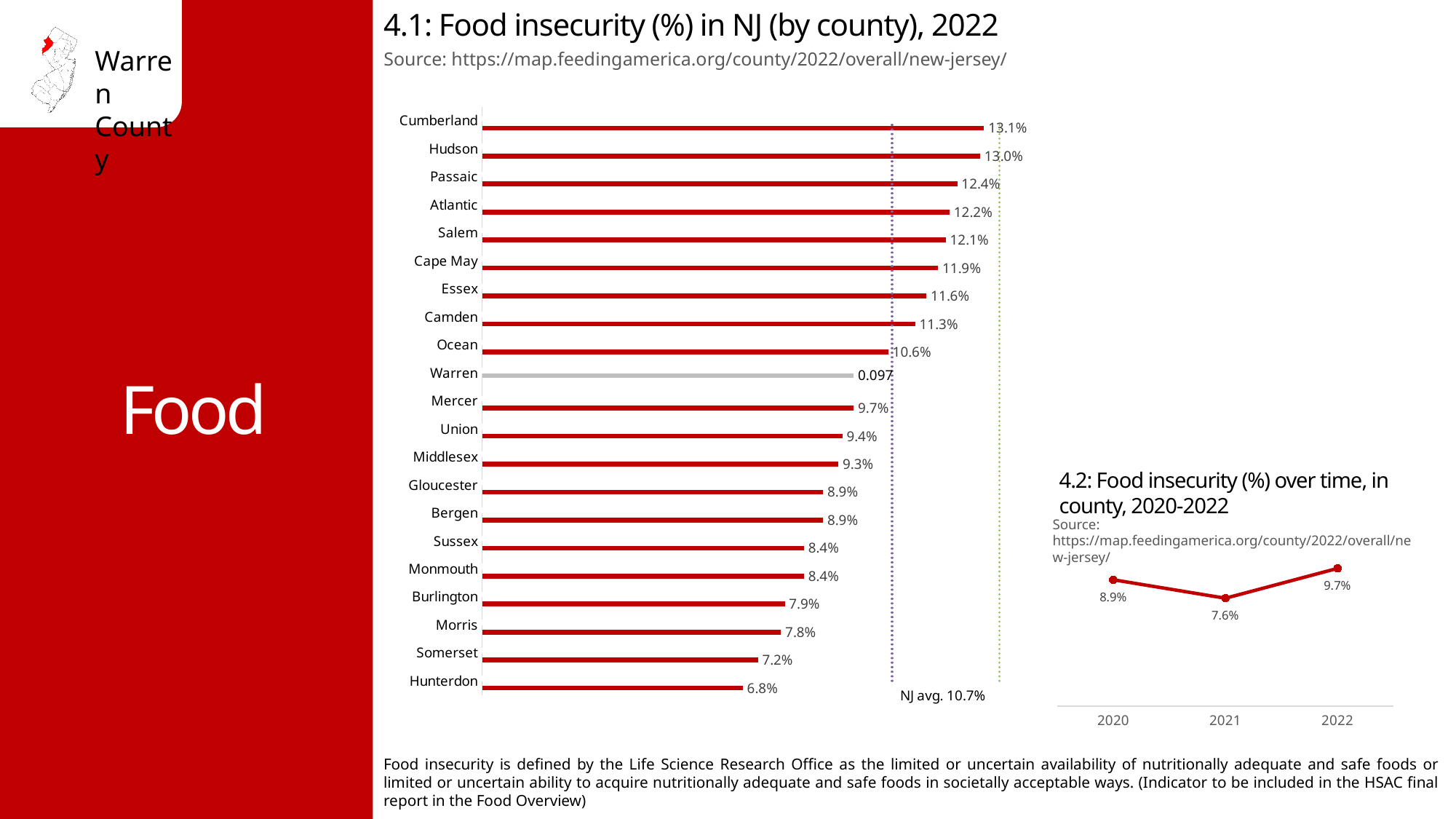
In chart 4.1, which county has the highest food insecurity rate? Cumberland In chart 4.1, what NJ average value is marked by the dotted reference line? 10.7% In chart 4.1, what is the food insecurity rate for Ocean? 10.6% In chart 4.2, what is the food insecurity rate for 2021? 7.6% In chart 4.1, what is the difference between the food insecurity rates of Cumberland and Hunterdon? 6.3% How many counties are shown in chart 4.1? 21 What kind of chart is 4.2: Food insecurity (%) over time, in county, 2020-2022? line chart In chart 4.1, which county has the lowest food insecurity rate? Hunterdon In chart 4.2, what is the difference between the food insecurity rates for 2022 and 2021? 2.1% In chart 4.1, which county has a higher food insecurity rate, Essex or Camden? Essex What kind of chart is 4.1: Food insecurity (%) in NJ (by county), 2022? bar chart In chart 4.1, what is the food insecurity rate for Passaic? 12.4%